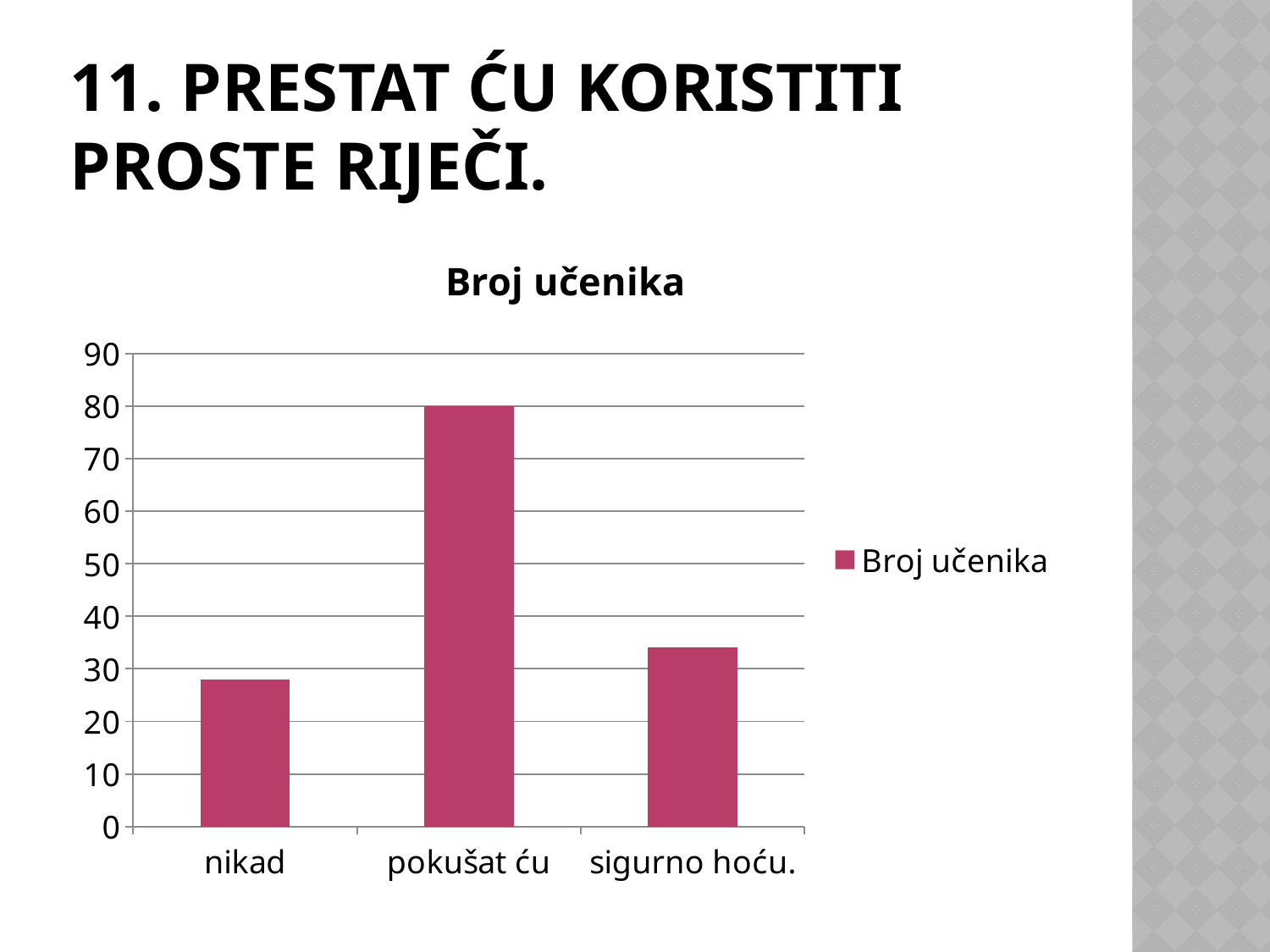
Is the value for nikad greater or less than 20? greater How many series does the legend list? 1 What is the value for pokušat ću in the Broj učenika chart? 80 How many categories are shown on the x axis of the chart? 3 What is the title of the chart? Broj učenika Is the value for nikad greater or less than 30? less Is the value for sigurno hoću. greater or less than 40? less What kind of chart is shown on the slide? bar chart Which category has the highest value in the Broj učenika chart? pokušat ću Which is larger, the value for nikad or the value for sigurno hoću.? sigurno hoću. Which category has the lowest value in the Broj učenika chart? nikad